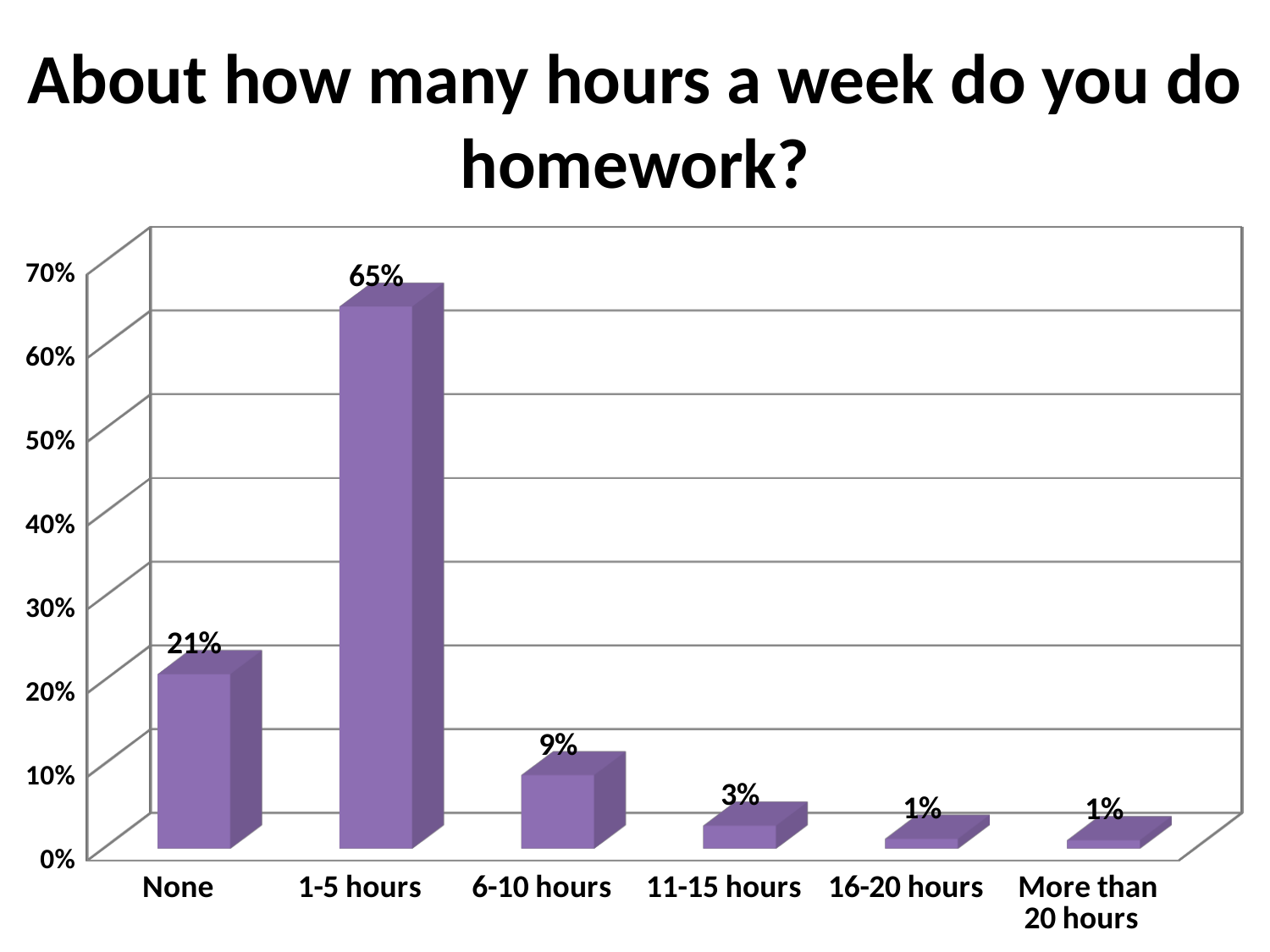
What percentage of respondents do 6-10 hours of homework a week? 9% What percentage of respondents do 1-5 hours of homework a week? 65% What kind of chart is shown on the slide? bar chart What is the value for 11-15 hours? 3% Which is larger, the value for None or the value for 6-10 hours? None Is the value for 1-5 hours greater or less than 60%? greater How many categories are shown on the x axis? 6 Which category has the highest value? 1-5 hours What is the title of the chart? About how many hours a week do you do homework? What is the difference between the values for 6-10 hours and 11-15 hours? 6% What is the difference between the values for 1-5 hours and None? 44% What is the value for the None category? 21%